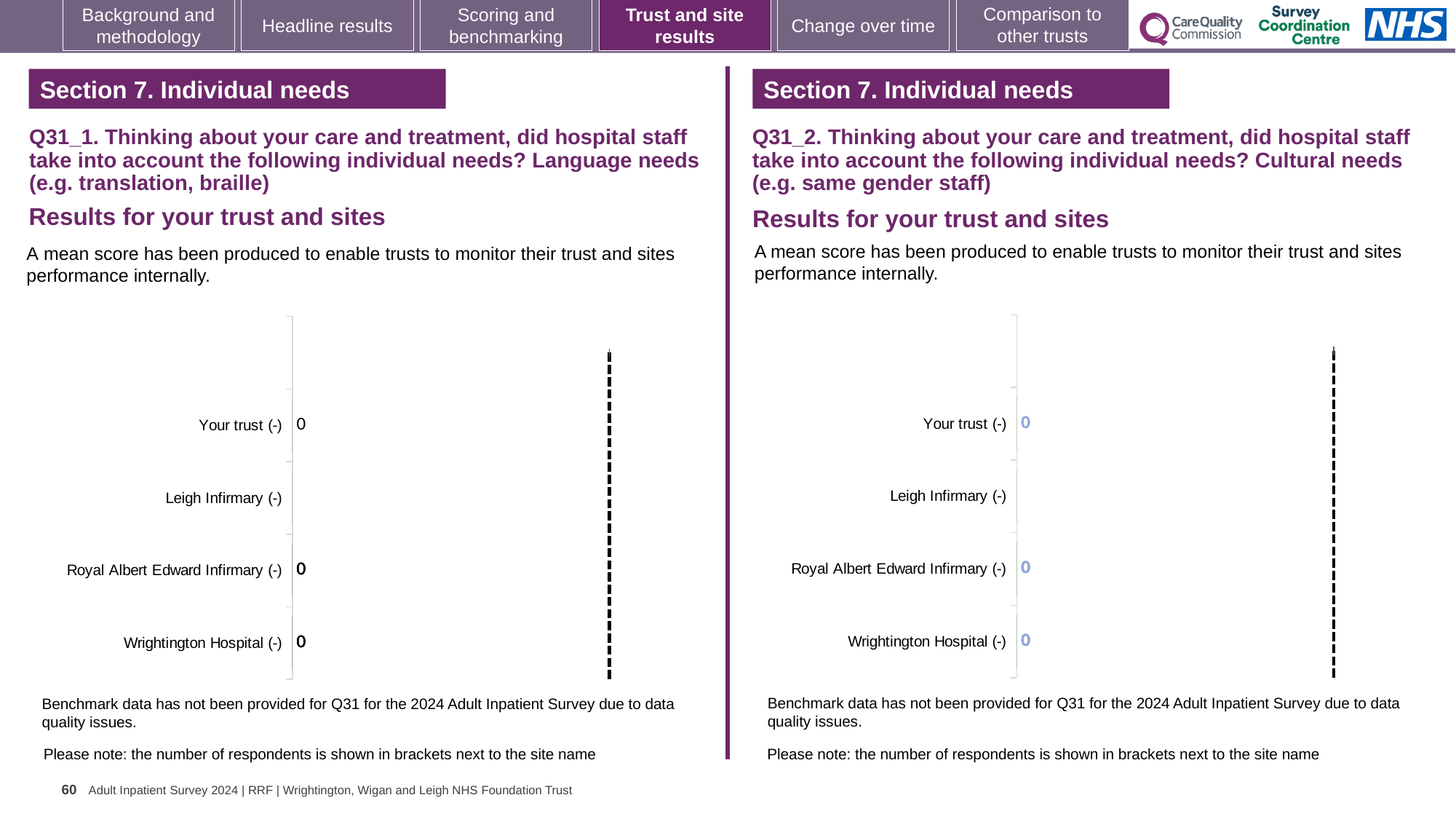
In the left chart (Q31_1, Language needs), what is the value shown for Wrightington Hospital? 0 In the left chart (Q31_1, Language needs), what is the value shown for Royal Albert Edward Infirmary? 0 In the left chart (Q31_1, Language needs), what is the value shown for Your trust? 0 In the right chart (Q31_2, Cultural needs), which category has no value label shown? Leigh Infirmary (-) In the right chart (Q31_2, Cultural needs), what is the value shown for Royal Albert Edward Infirmary? 0 What kind of chart is the right chart (Q31_2, Cultural needs)? Bar chart How many categories are listed on the y axis of the left chart (Q31_1, Language needs)? 4 How many categories are listed on the y axis of the right chart (Q31_2, Cultural needs)? 4 In the left chart (Q31_1, Language needs), which category has no value label shown? Leigh Infirmary (-) In the right chart (Q31_2, Cultural needs), what is the value shown for Your trust? 0 What kind of chart is the left chart (Q31_1, Language needs)? Bar chart In the right chart (Q31_2, Cultural needs), what is the value shown for Wrightington Hospital? 0